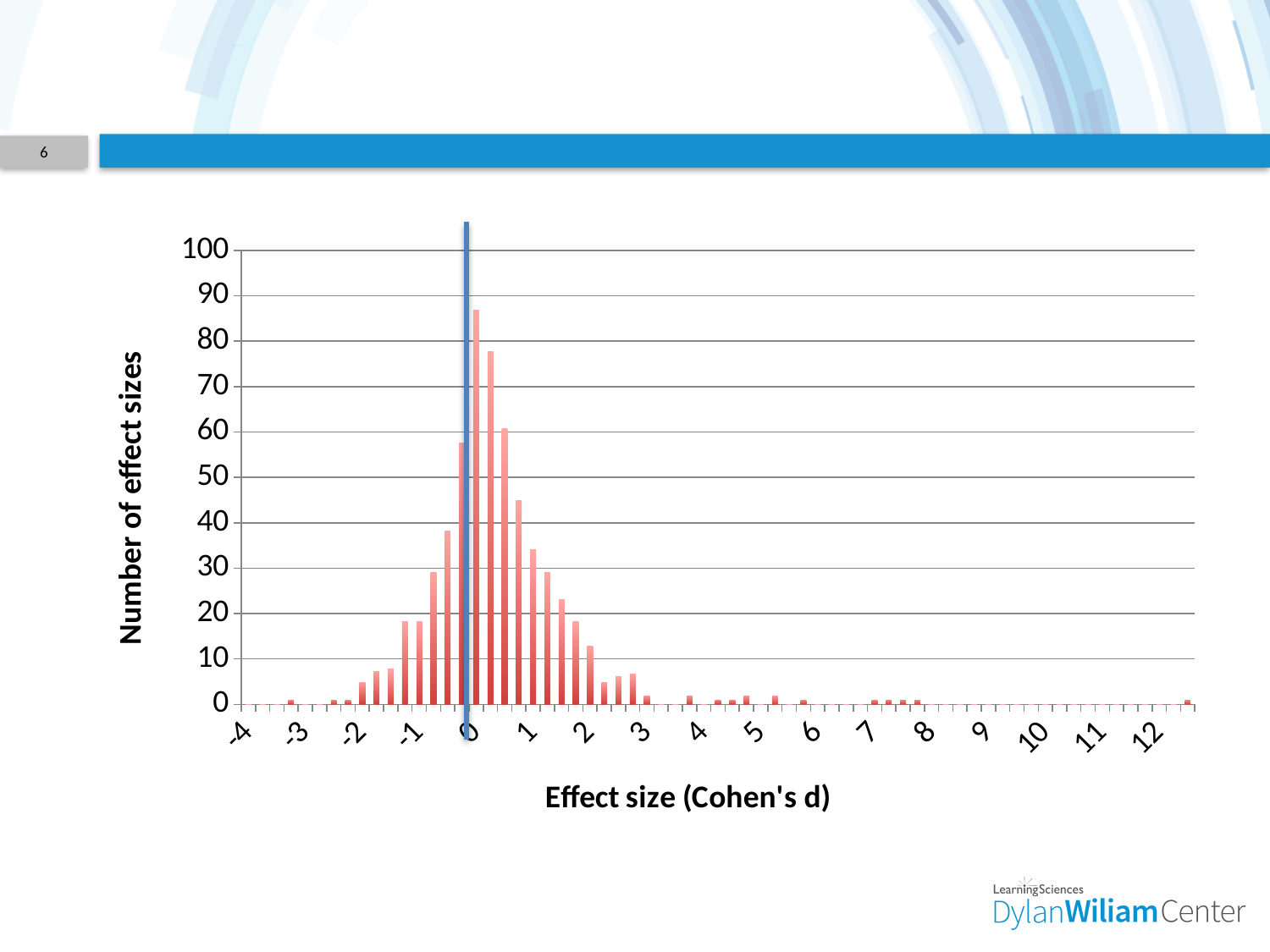
Which has more effect sizes: an effect size of -1 or an effect size of 1? 1 Do the bar heights rise or fall as the effect size increases from 0 to 3? fall Which has more effect sizes: an effect size of 2 or an effect size of 4? 2 Is the number of effect sizes at an effect size of 3 greater or less than 10? less What is the title of the horizontal axis of the chart? Effect size (Cohen's d) Is the number of effect sizes at an effect size of -1 greater or less than 10? greater What is the title of the vertical axis of the chart? Number of effect sizes Is the number of effect sizes at an effect size of 6 greater or less than 10? less Do the bar heights rise or fall as the effect size increases from -2 to 0? rise What kind of chart is shown on the slide? bar chart